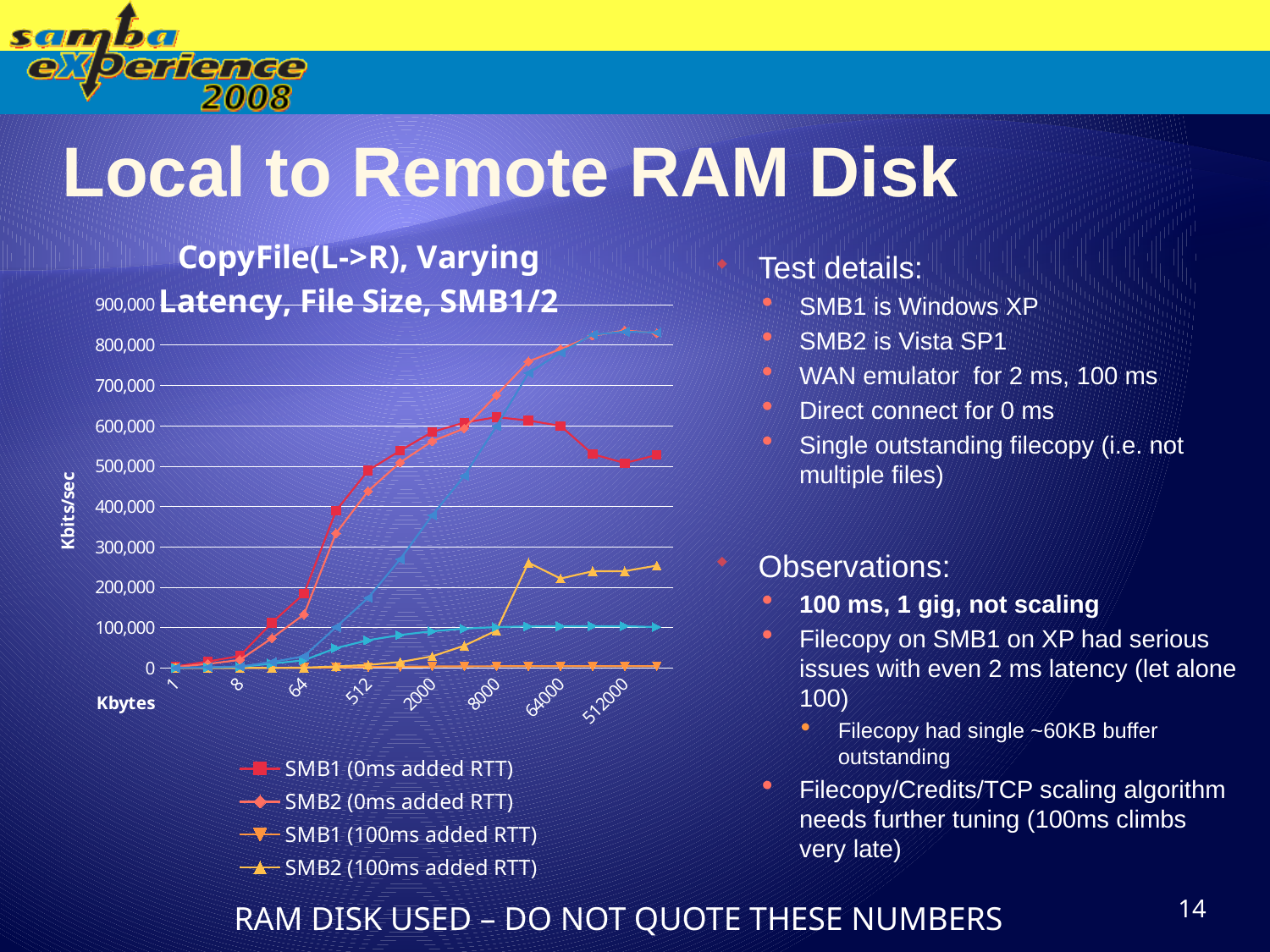
At 512000 Kbytes, which is larger: SMB2 (0ms added RTT) or SMB1 (0ms added RTT)? SMB2 (0ms added RTT) How many labelled tick values are shown on the x axis (Kbytes)? 8 Is the value for SMB2 (0ms added RTT) at 512000 Kbytes greater or less than 700,000? greater Does the SMB2 (0ms added RTT) series generally rise or fall as file size increases along the x axis? Rise Which legend series stays lowest across the chart? SMB1 (100ms added RTT) What is the label on the chart's y axis? Kbits/sec What kind of chart is shown on the slide? Line chart Is the value for SMB2 (100ms added RTT) at 512000 Kbytes greater or less than 200,000? greater Is the value for SMB1 (0ms added RTT) at 512000 Kbytes greater or less than 600,000? less How many series does the chart legend list? 4 Which series reaches the highest value on the chart? SMB2 (0ms added RTT)